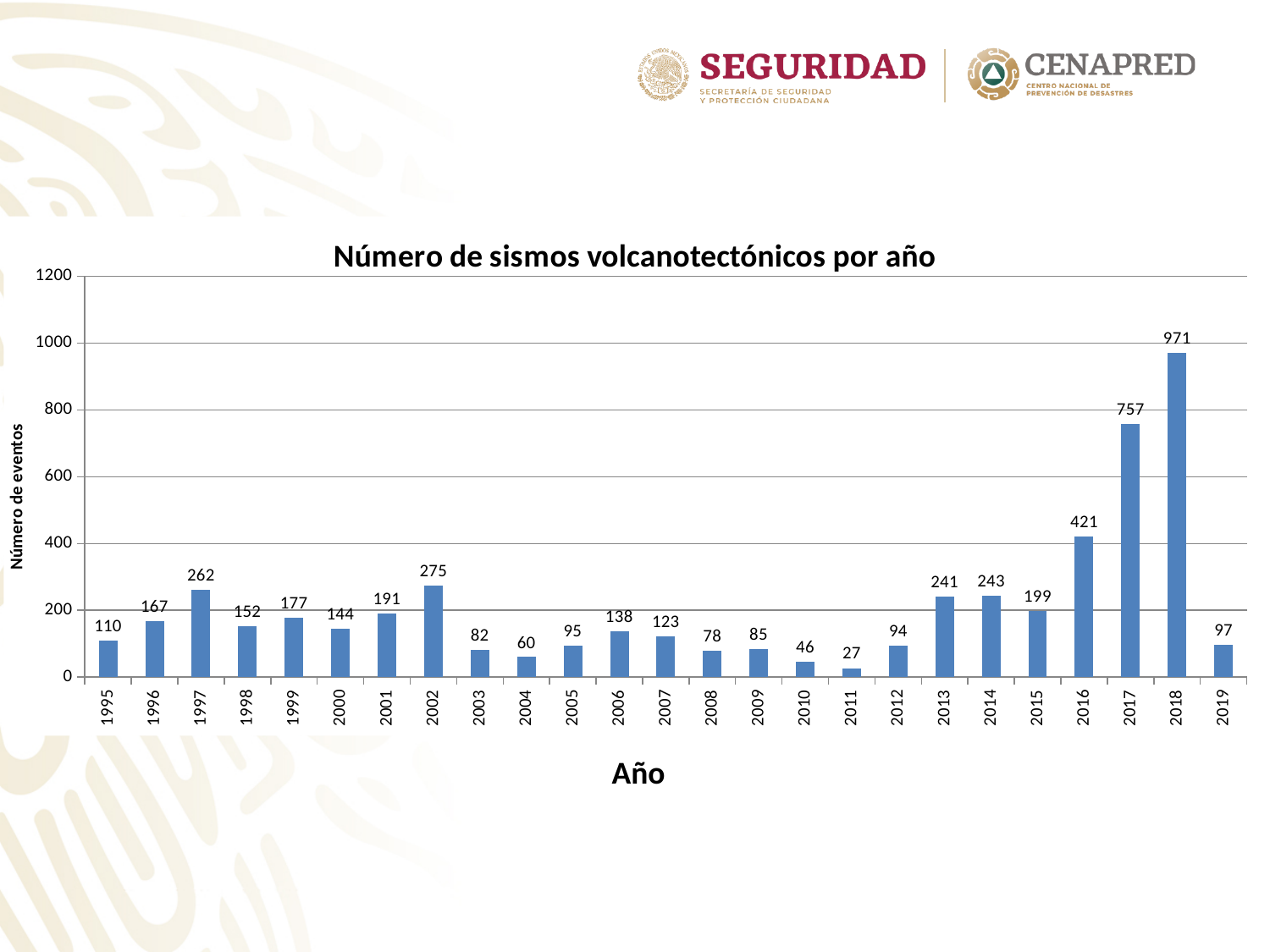
What value is shown for the year 2011? 27 Which year has the highest number of events? 2018 How many years are shown on the x axis? 25 What is the difference between the values for 2018 and 2017? 214 Do the values rise or fall from 2015 to 2018? Rise What kind of chart is this? Bar chart Which year has a larger value, 2013 or 2014? 2014 What is the number of volcano-tectonic earthquakes shown for 2018? 971 What is the title of the chart? Número de sismos volcanotectónicos por año Is the value for 2016 greater or less than 400? greater Which year has the lowest number of events? 2011 What value is shown for the year 2002? 275